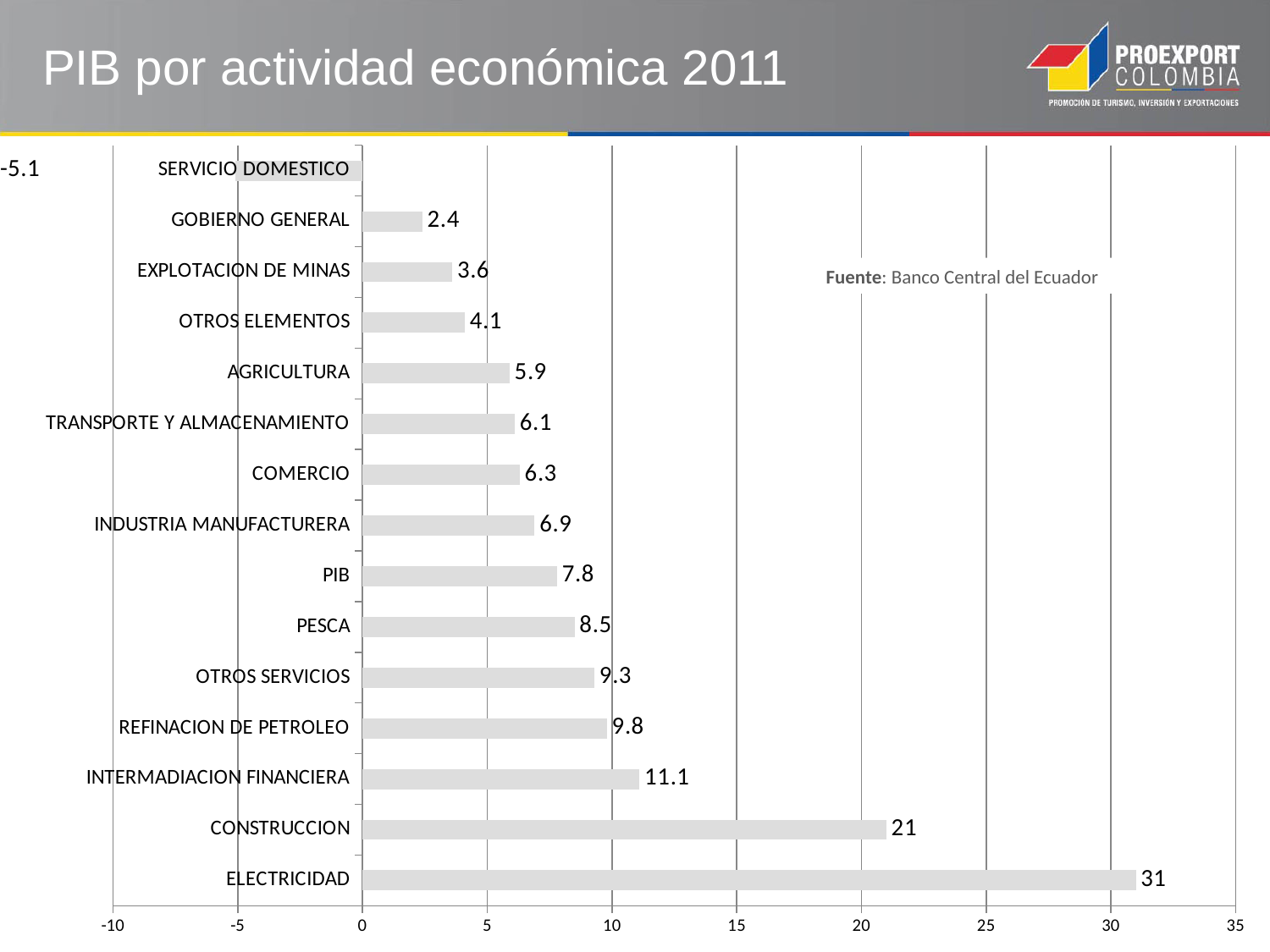
What is the value for CONSTRUCCION? 21 What is the difference between the values for ELECTRICIDAD and CONSTRUCCION? 10 What is the value for PIB? 7.8 What source is cited for the chart data? Banco Central del Ecuador How many categories are shown in the chart? 15 What is the value for ELECTRICIDAD? 31 What is the value for SERVICIO DOMESTICO? -5.1 Which category has the lowest value? SERVICIO DOMESTICO Which is larger, the value for PESCA or the value for COMERCIO? PESCA Is the value for INTERMADIACION FINANCIERA greater or less than 10? greater What kind of chart is shown on the slide? bar chart Which category has the highest value? ELECTRICIDAD